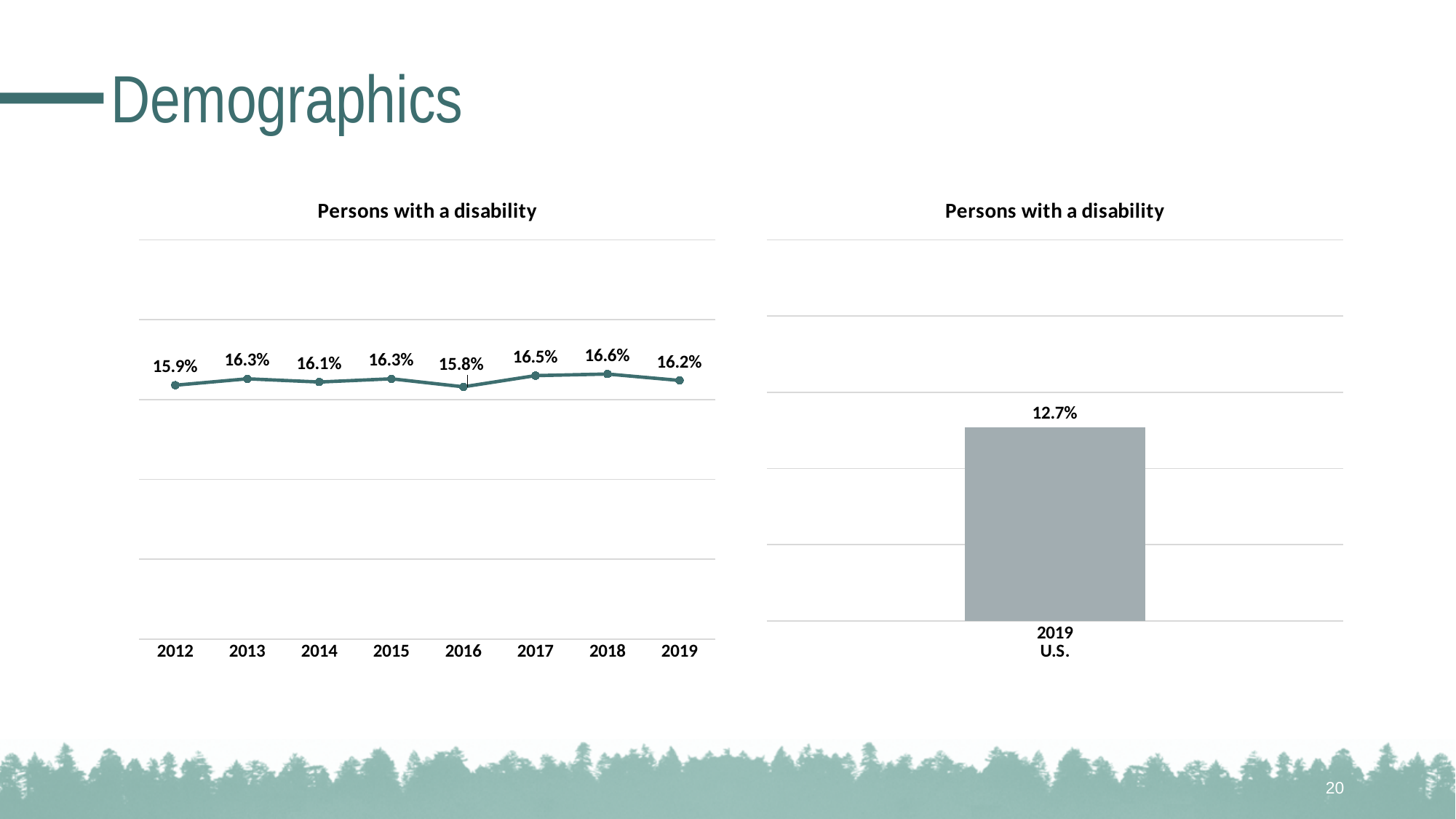
In the line chart on the left, which year has the highest value? 2018 In the bar chart on the right, what is the value for 2019 U.S.? 12.7% What is the title of the chart on the right? Persons with a disability What kind of chart is the chart on the right? bar chart In the line chart on the left, what is the value for 2012? 15.9% How many years are plotted in the line chart on the left? 8 In the line chart on the left, which is larger, the value for 2017 or the value for 2014? 2017 What kind of chart is the chart on the left? line chart In the line chart on the left, which year has the lowest value? 2016 In the line chart on the left, what is the difference between the 2018 value and the 2016 value? 0.8% In the line chart on the left, what is the value for 2016? 15.8% In the line chart on the left, what is the value for 2019? 16.2%